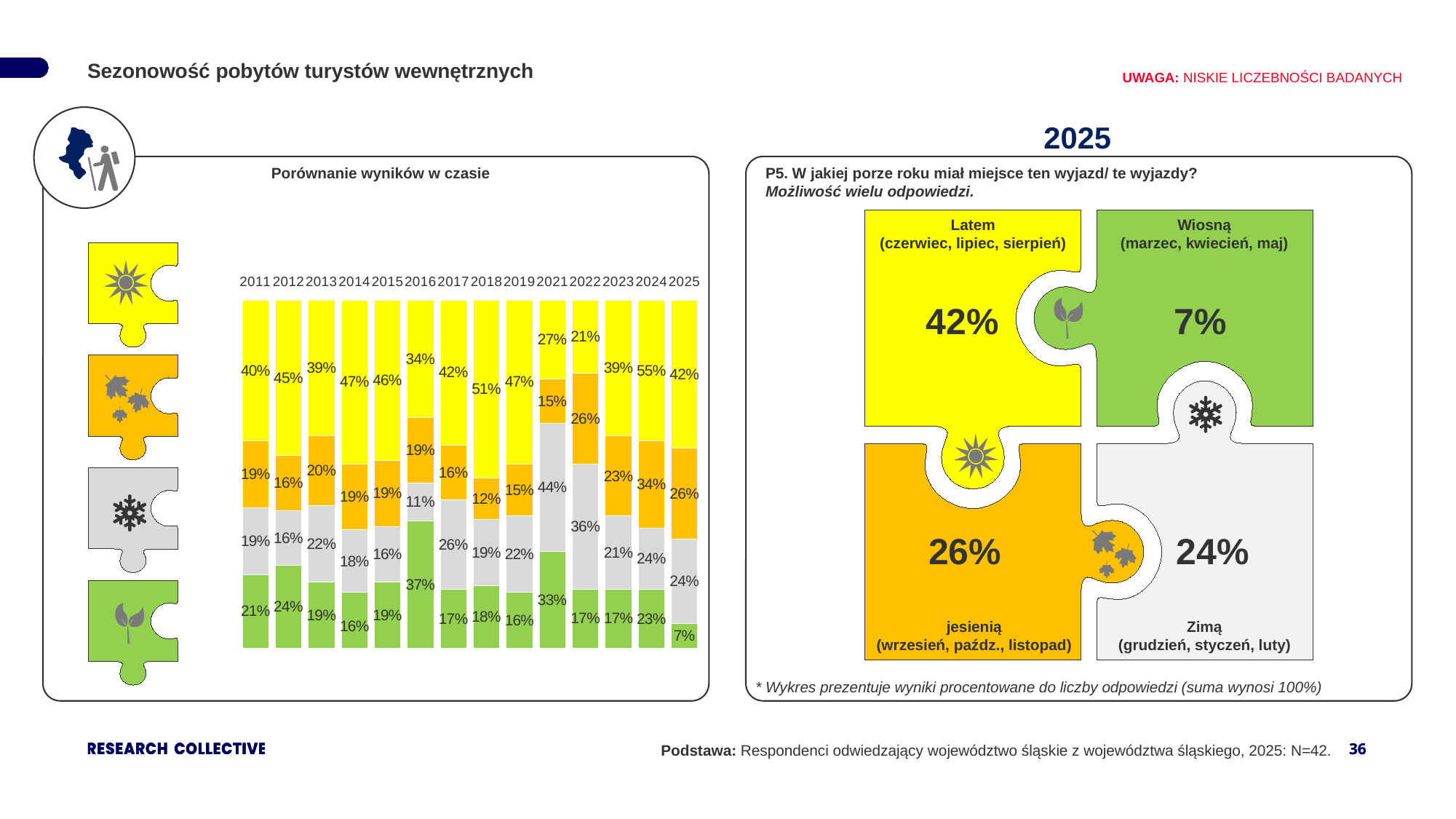
In the chart 'Porównanie wyników w czasie', what is the value of the green (bottom) segment for 2025? 7% In the chart 'Porównanie wyników w czasie', is the green (bottom) segment larger in 2016 or in 2021? 2016 What kind of chart is 'Porównanie wyników w czasie'? Stacked bar chart In the chart 'Porównanie wyników w czasie', what is the difference between the yellow segment values for 2024 and 2025? 13 percentage points In the chart 'Porównanie wyników w czasie', what is the value of the yellow (top) segment for 2018? 51% In the 2025 puzzle chart on the right, what is the value for 'Latem (czerwiec, lipiec, sierpień)'? 42% What is the title of the stacked bar chart on the left side of the slide? Porównanie wyników w czasie In the chart 'Porównanie wyników w czasie', which year has the highest value for the yellow (top) segment? 2024 In the 2025 puzzle chart on the right, which season has the lowest value? Wiosną (marzec, kwiecień, maj) In the chart 'Porównanie wyników w czasie', what is the value of the grey segment for 2021? 44% In the chart 'Porównanie wyników w czasie', how many years are shown along the x axis? 14 In the 2025 puzzle chart on the right, what is the difference between the values for 'Latem' and 'Zimą'? 18 percentage points